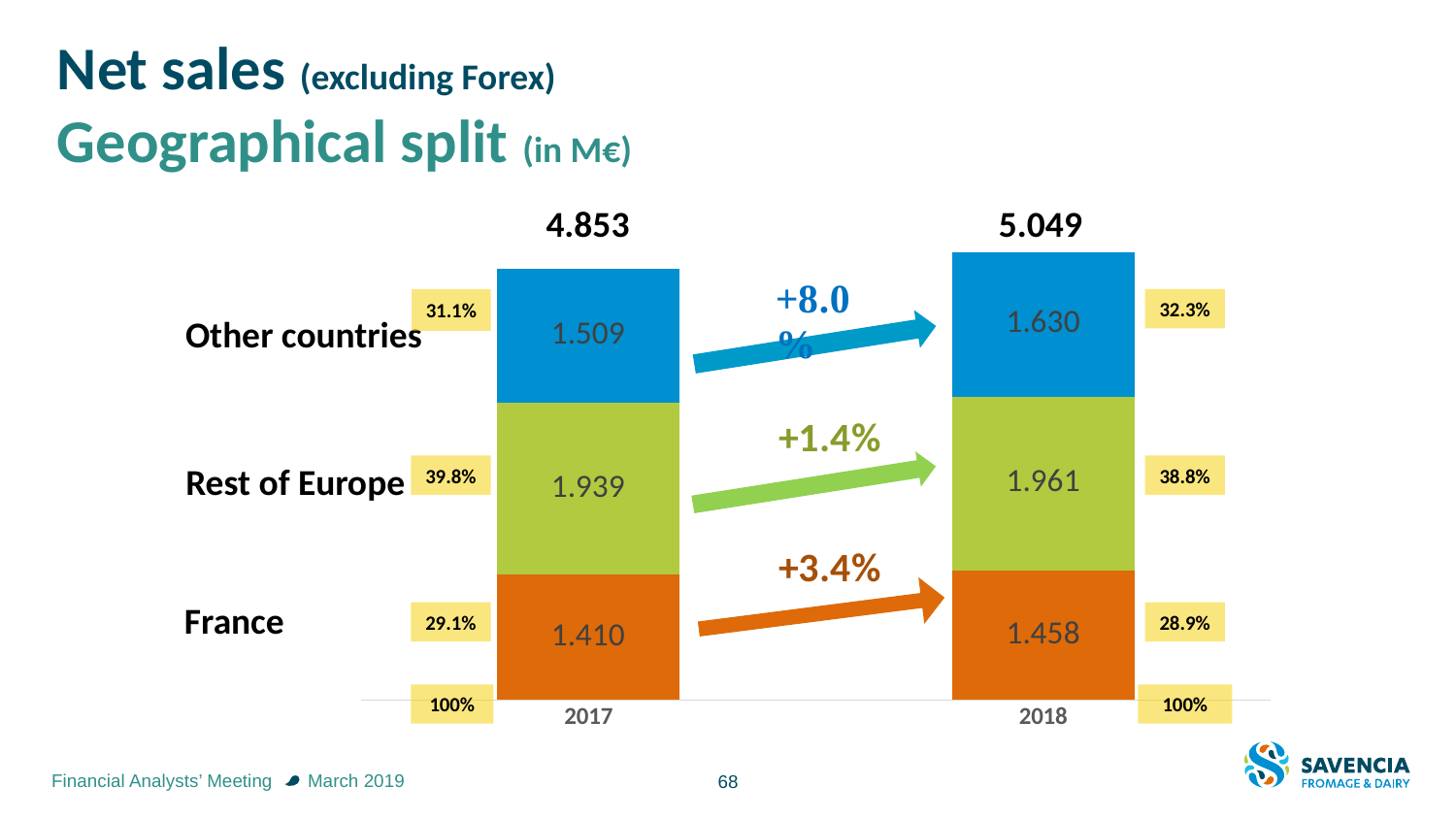
Which region had the lowest net sales in 2017? France What share of 2018 net sales came from Other countries? 32.3% What growth rate is shown on the arrow for Other countries between 2017 and 2018? +8.0% What was the net sales value for Other countries in 2018? 1.630 What is the difference between the Rest of Europe net sales in 2018 and 2017? 22 What kind of chart is shown on the slide? Stacked bar chart What was the net sales value for France in 2017? 1.410 What is the total net sales shown for 2018? 5.049 Which region had the highest net sales in 2018? Rest of Europe What is the total net sales shown for 2017? 4.853 Which is larger: France net sales in 2018 or Other countries net sales in 2018? Other countries net sales in 2018 What was the net sales value for Rest of Europe in 2017? 1.939